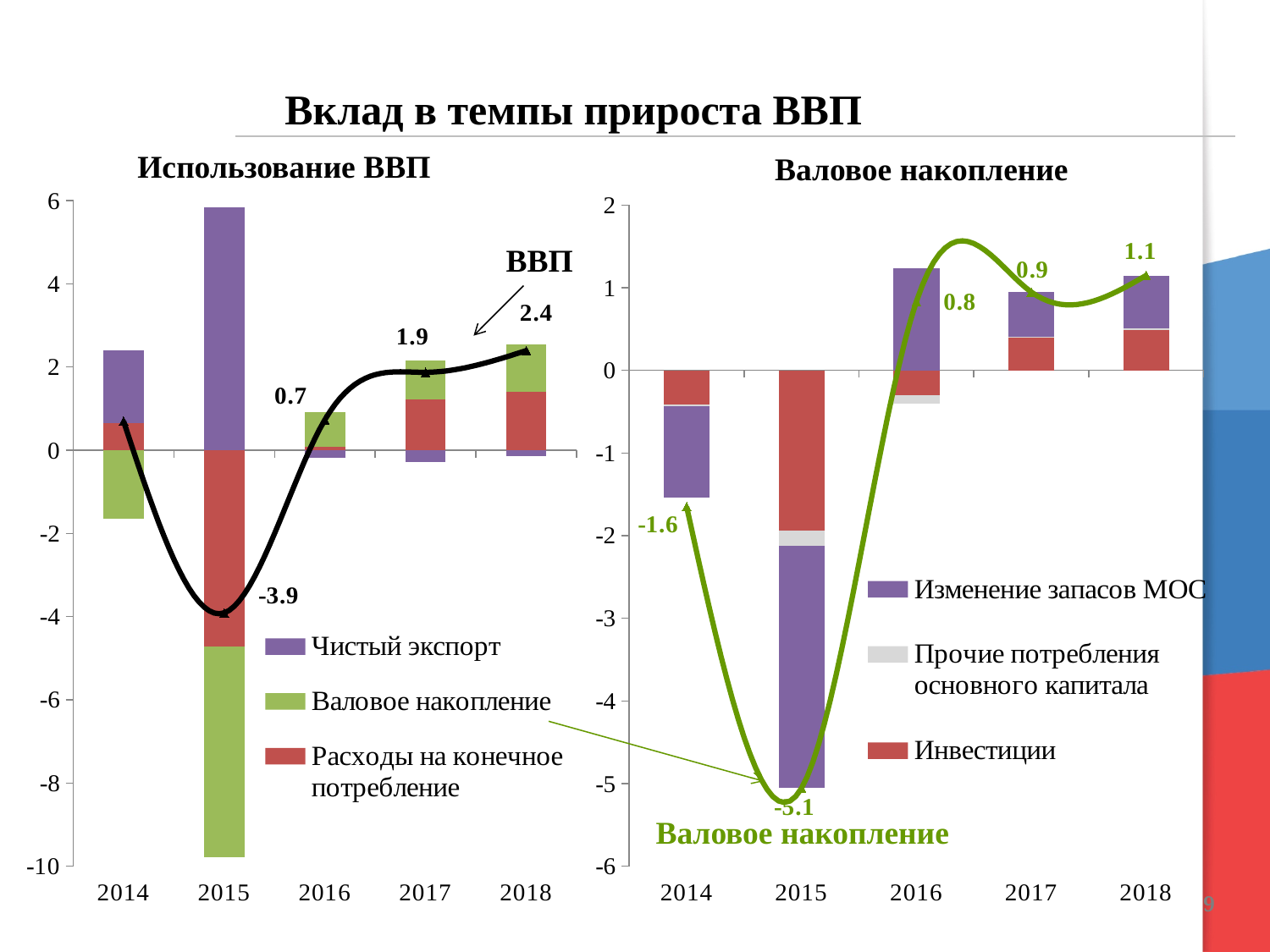
In the 'Валовое накопление' chart, what is the Валовое накопление value for 2018? 1.1 In the 'Использование ВВП' chart, is the Чистый экспорт value for 2015 greater or less than 4? greater In the 'Использование ВВП' chart, what is the ВВП value for 2017? 1.9 In the 'Валовое накопление' chart, what is the Валовое накопление value for 2015? -5.1 In the 'Использование ВВП' chart, what is the difference between the ВВП values for 2018 and 2017? 0.5 In the 'Использование ВВП' chart, how many series does the legend list? 3 In the 'Валовое накопление' chart, which year has the highest Валовое накопление value on the line? 2018 In the 'Использование ВВП' chart, what is the ВВП value for 2015? -3.9 In the 'Использование ВВП' chart, how many years are shown on the x axis? 5 In the 'Использование ВВП' chart, which year has the lowest ВВП value on the line? 2015 In the 'Валовое накопление' chart, does the Валовое накопление line rise or fall from 2016 to 2018? rise In the 'Валовое накопление' chart, which is larger, the Валовое накопление value for 2014 or for 2015? 2014